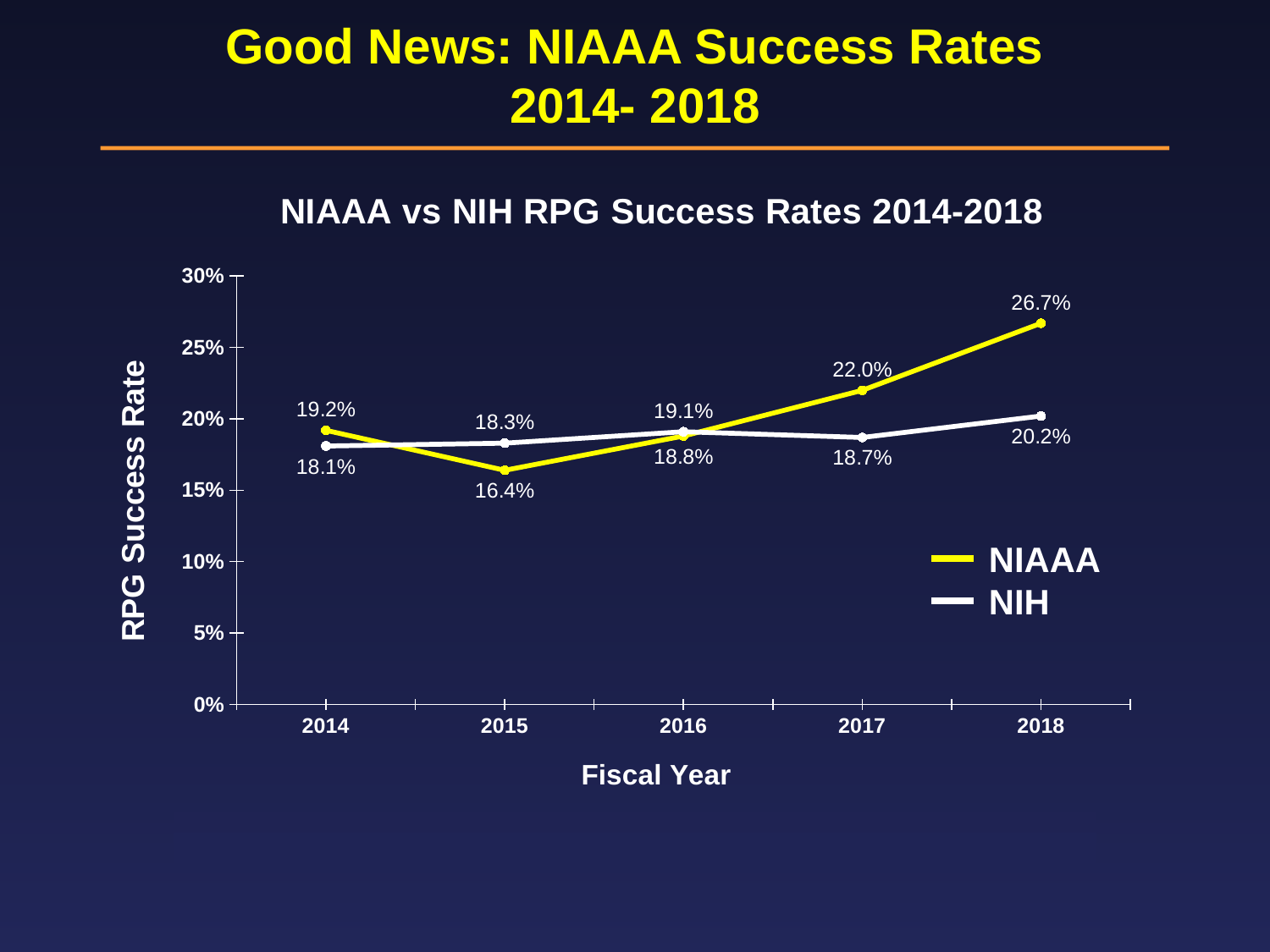
Does the NIAAA success rate rise or fall from 2015 to 2018? Rise Which series has the higher success rate in 2017, NIAAA or NIH? NIAAA In which fiscal year is the NIAAA success rate highest? 2018 How many series does the legend list? 2 What is the NIAAA RPG success rate for fiscal year 2018? 26.7% How many fiscal years are plotted on the x axis? 5 What is the NIH RPG success rate for fiscal year 2015? 18.3% Which series has the higher success rate in 2015, NIAAA or NIH? NIH What is the difference between the NIAAA and NIH success rates in 2018? 6.5% What kind of chart is shown on the slide? Line chart In which fiscal year is the NIAAA success rate lowest? 2015 What is the NIAAA RPG success rate for fiscal year 2015? 16.4%